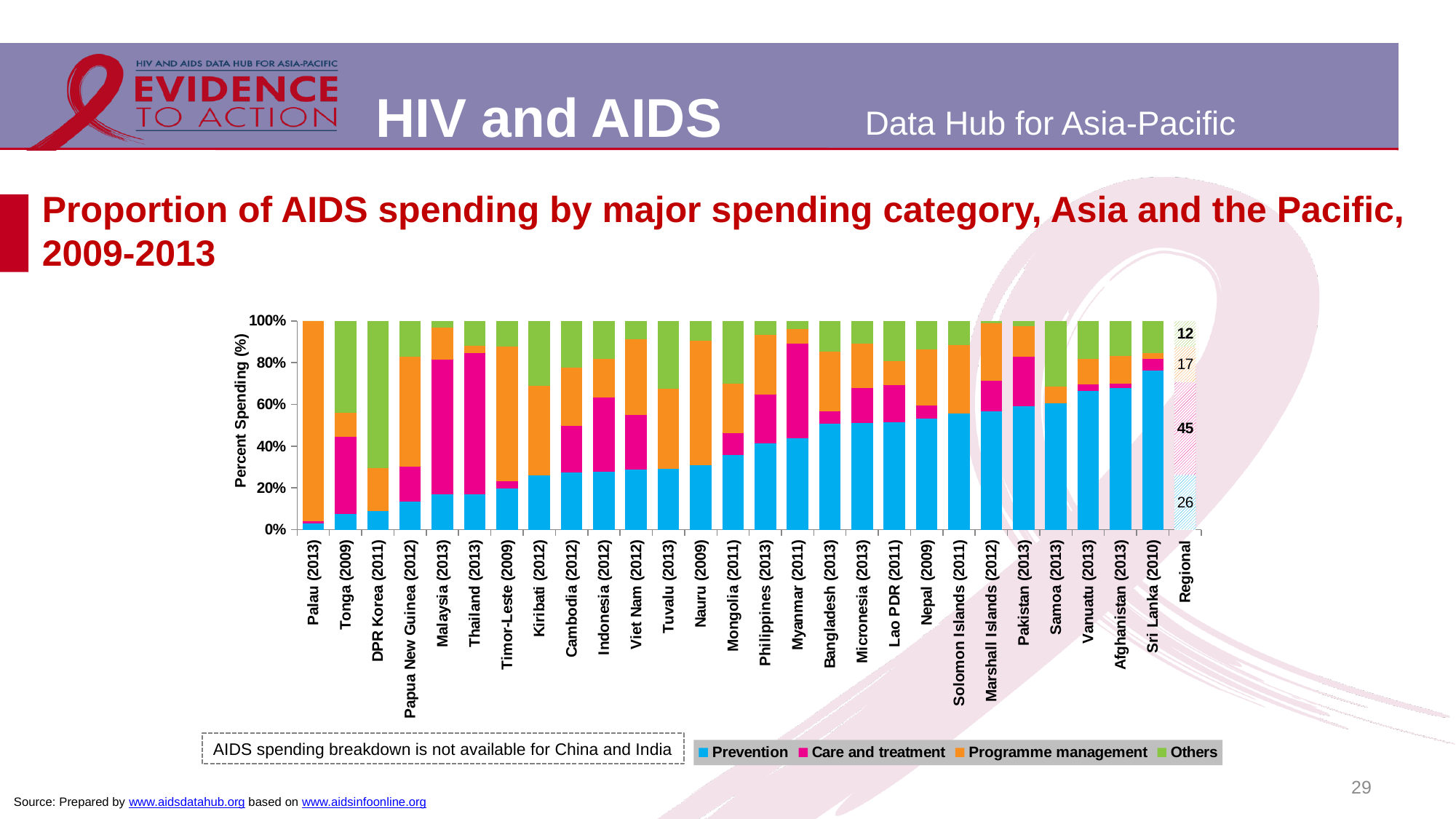
What is the Programme management value shown for the Regional bar? 17 Do the Prevention shares generally rise or fall moving from left to right across the country bars? Rise What is the Prevention value shown for the Regional bar? 26 How many series does the legend list? 4 Is the Prevention share for Sri Lanka (2010) greater or less than 60%? greater Which country has the lowest Prevention share? Palau (2013) What is the total of the four labelled values in the Regional bar? 100 What is the Others value shown for the Regional bar? 12 What kind of chart is shown on the slide? Stacked bar chart Which has the larger Care and treatment share, Thailand (2013) or Tonga (2009)? Thailand (2013) Which country has the highest Prevention share? Sri Lanka (2010) What is the Care and treatment value shown for the Regional bar? 45